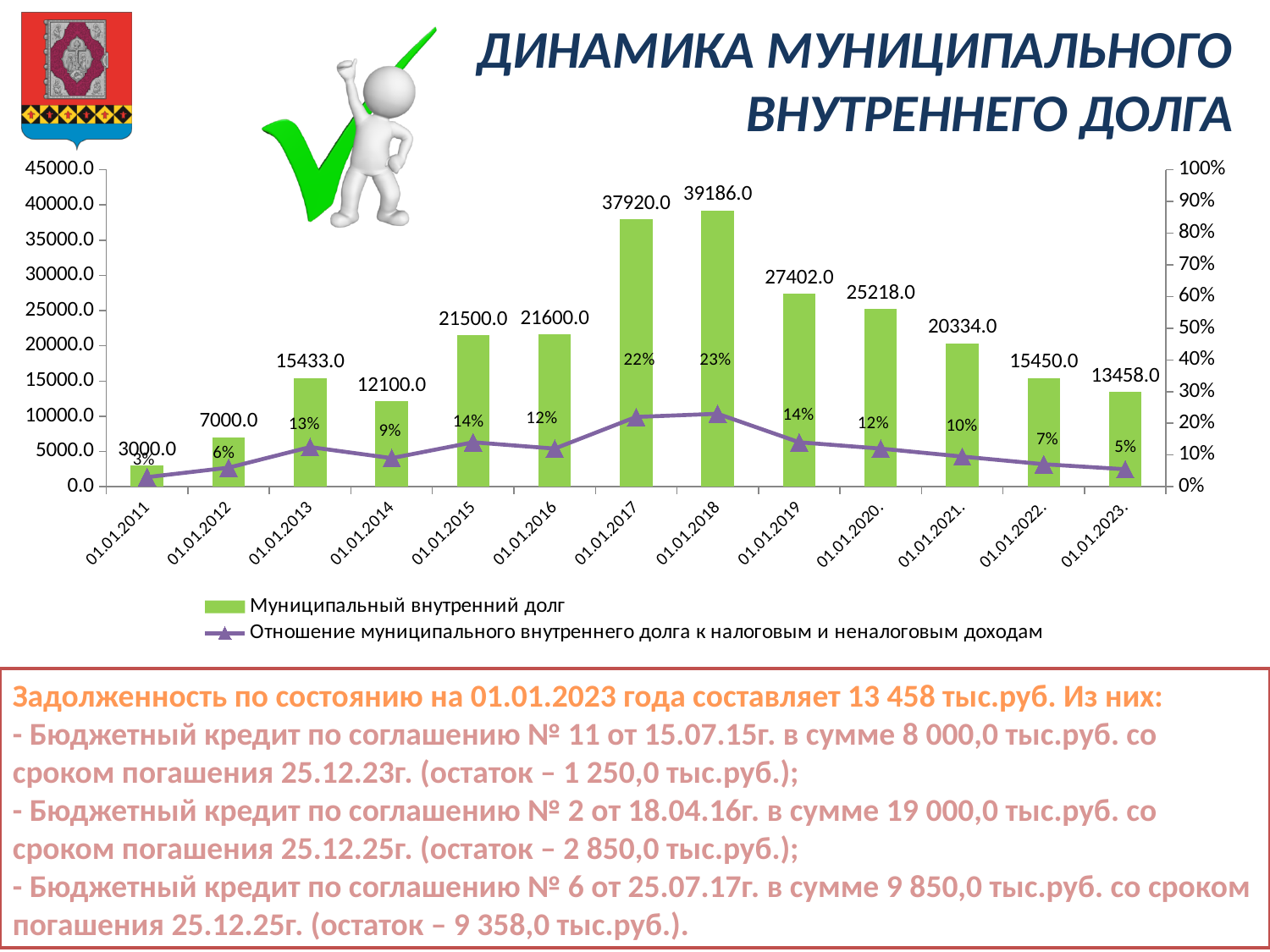
Which is larger, the municipal internal debt for 01.01.2013 or for 01.01.2014? 01.01.2013 What kind of chart is shown on the slide? Combined bar and line chart What is the ratio of municipal internal debt to tax and non-tax revenues (the line series) for 01.01.2017? 22% What is the value of the municipal internal debt (Муниципальный внутренний долг) bar for 01.01.2018? 39186.0 Does the municipal internal debt rise or fall from 01.01.2018 to 01.01.2023? Fall What is the difference between the municipal internal debt values for 01.01.2018 and 01.01.2017? 1266.0 How many series does the chart legend list? 2 How many dates are shown on the x axis of the chart? 13 What is the value of the municipal internal debt bar for 01.01.2023? 13458.0 What is the title of the chart on the slide? ДИНАМИКА МУНИЦИПАЛЬНОГО ВНУТРЕННЕГО ДОЛГА Which date has the lowest municipal internal debt bar? 01.01.2011 Which date has the highest municipal internal debt bar? 01.01.2018